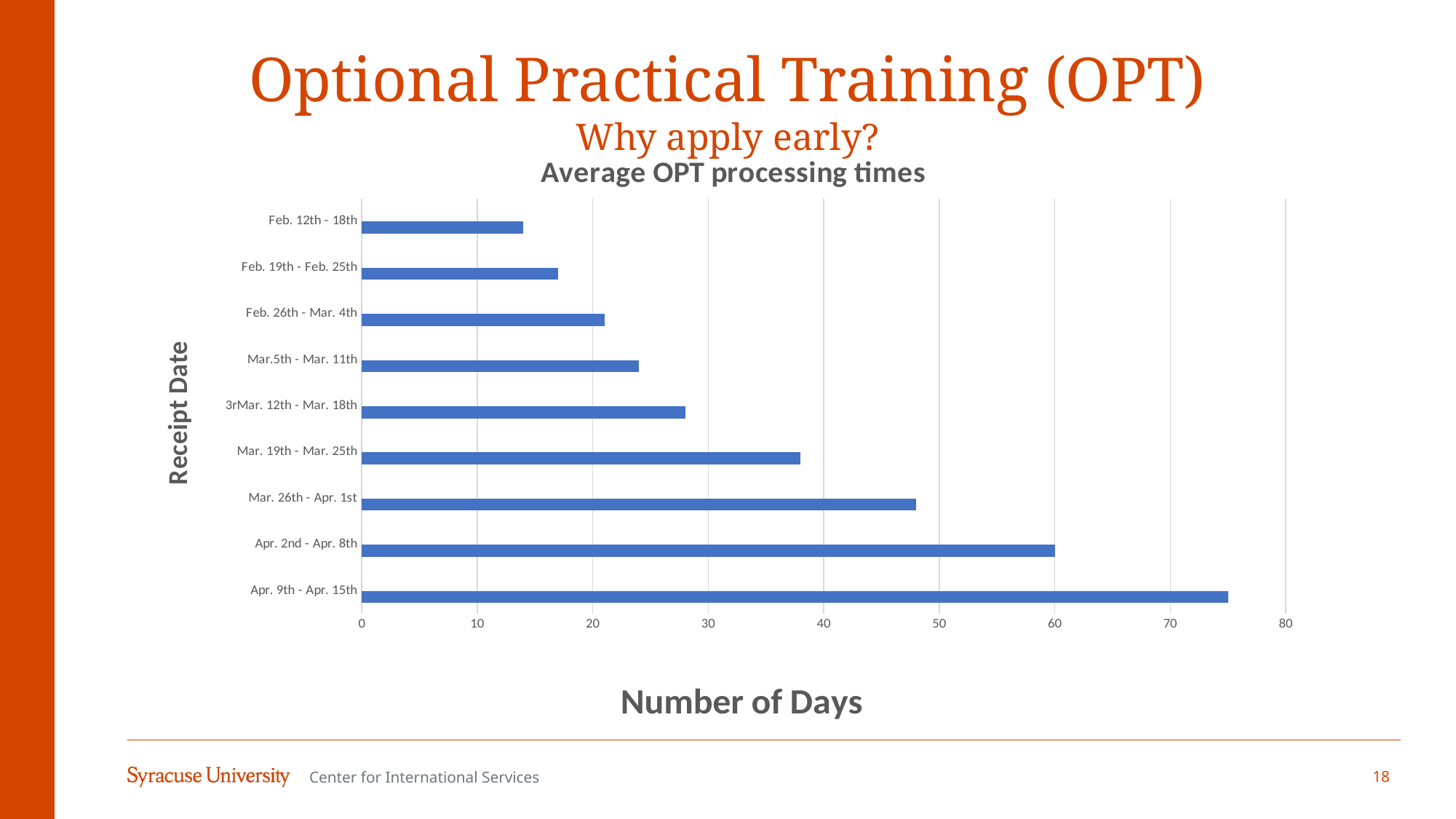
What type of chart is shown on the slide? Bar chart Is the value for Feb. 12th - 18th greater or less than 20? less Which has a longer average processing time, Apr. 2nd - Apr. 8th or Mar. 19th - Mar. 25th? Apr. 2nd - Apr. 8th What is the label of the horizontal axis? Number of Days Is the value for Mar. 19th - Mar. 25th greater or less than 30? greater How many receipt date categories are plotted in the chart? 9 Do the average processing times rise or fall as the receipt dates get later (moving down the chart)? Rise Which receipt date has the longest average processing time? Apr. 9th - Apr. 15th Which receipt date has the shortest average processing time? Feb. 12th - 18th Is the value for Mar. 26th - Apr. 1st greater or less than 50? less What is the title of the chart? Average OPT processing times